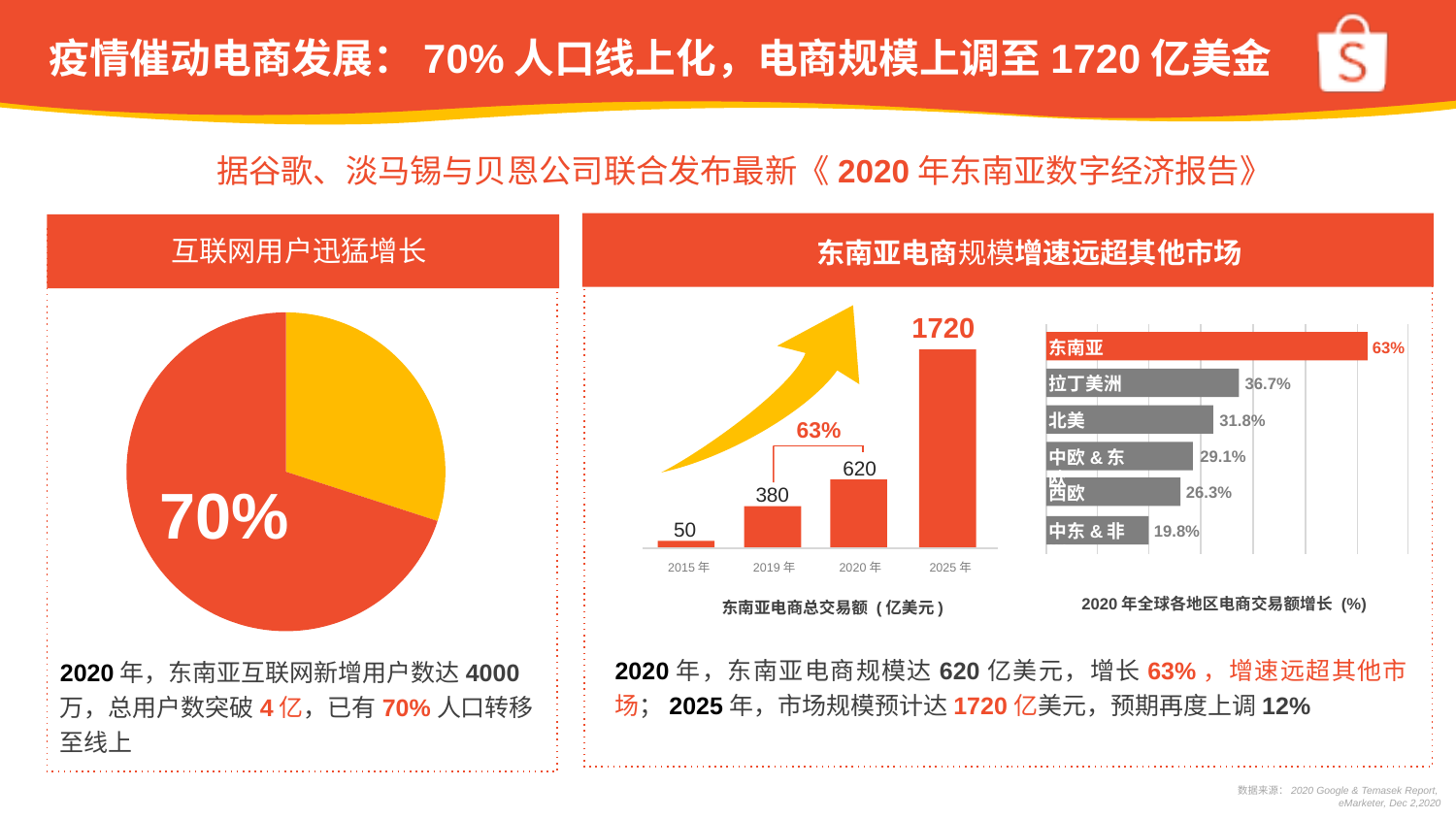
In the chart titled 2020 年全球各地区电商交易额增长 (%), which region has the lowest value? 中东 & 非 In the chart titled 东南亚电商总交易额（亿美元）, how many years are plotted? 4 In the chart titled 东南亚电商总交易额（亿美元）, what is the value for 2019 年? 380 In the chart titled 2020 年全球各地区电商交易额增长 (%), how many regions are shown? 6 In the chart titled 2020 年全球各地区电商交易额增长 (%), which region has the highest value? 东南亚 In the chart titled 东南亚电商总交易额（亿美元）, which year has the lowest value? 2015 年 What share of the pie chart under 互联网用户迅猛增长 is labelled? 70% In the chart titled 东南亚电商总交易额（亿美元）, what is the value for 2025 年? 1720 In the chart titled 2020 年全球各地区电商交易额增长 (%), what is the value for 拉丁美洲? 36.7% In the chart titled 东南亚电商总交易额（亿美元）, do the values rise or fall from 2015 年 to 2025 年? rise In the chart titled 东南亚电商总交易额（亿美元）, what is the difference between the 2025 年 and 2020 年 values? 1100 In the chart titled 2020 年全球各地区电商交易额增长 (%), which is larger, 北美 or 西欧? 北美